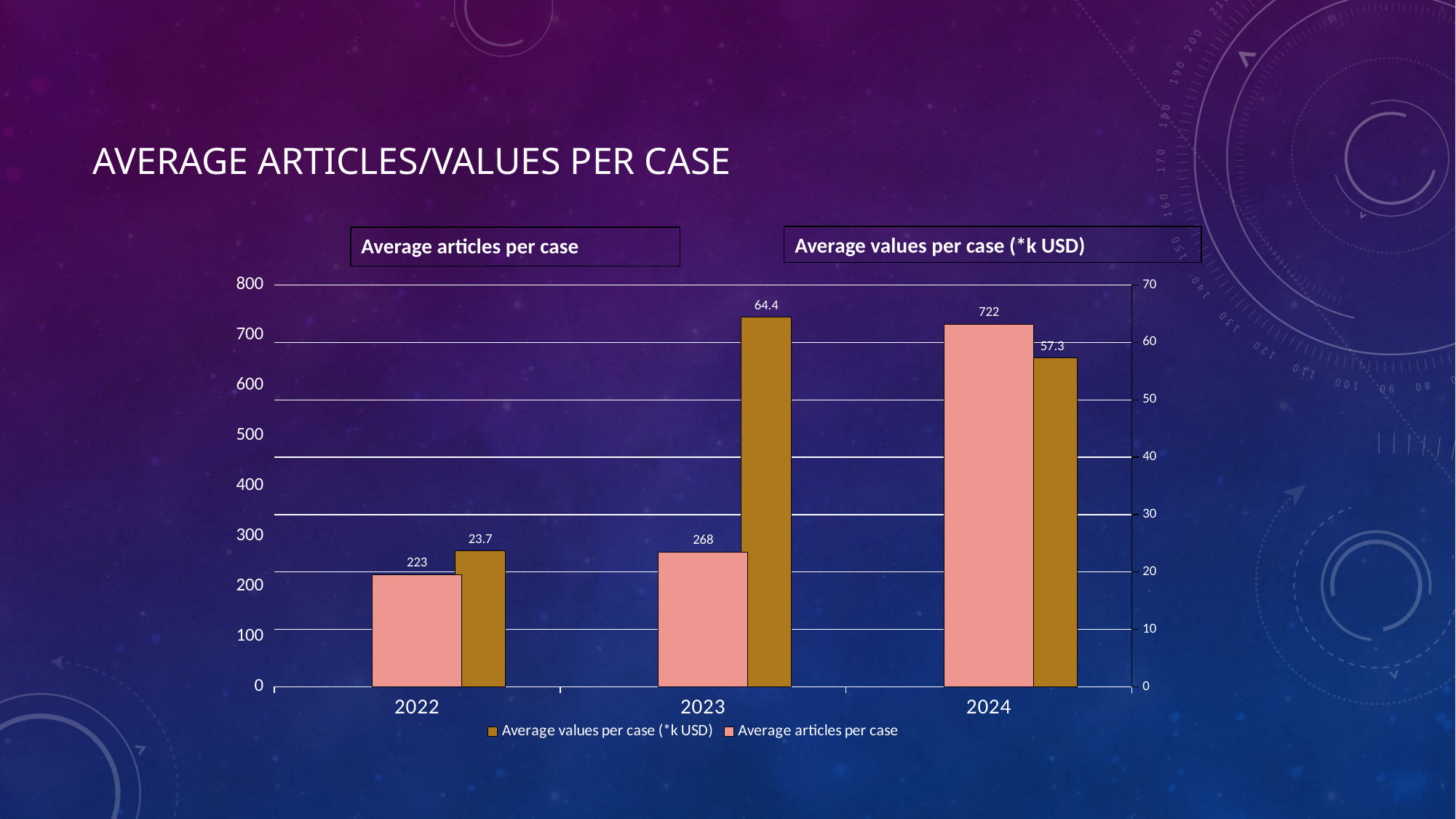
Which year has the lowest average value per case (*k USD)? 2022 Does the average number of articles per case rise or fall from 2022 to 2024? Rise What is the average value per case (*k USD) in 2024? 57.3 Which year has the higher average value per case (*k USD), 2023 or 2024? 2023 What is the average number of articles per case in 2022? 223 How many years are shown on the x axis? 3 How many series does the legend list? 2 What is the average number of articles per case in 2024? 722 What is the average value per case (*k USD) in 2023? 64.4 What is the difference in average articles per case between 2024 and 2023? 454 Which year has the highest average articles per case? 2024 What kind of chart is shown on the slide? Bar chart